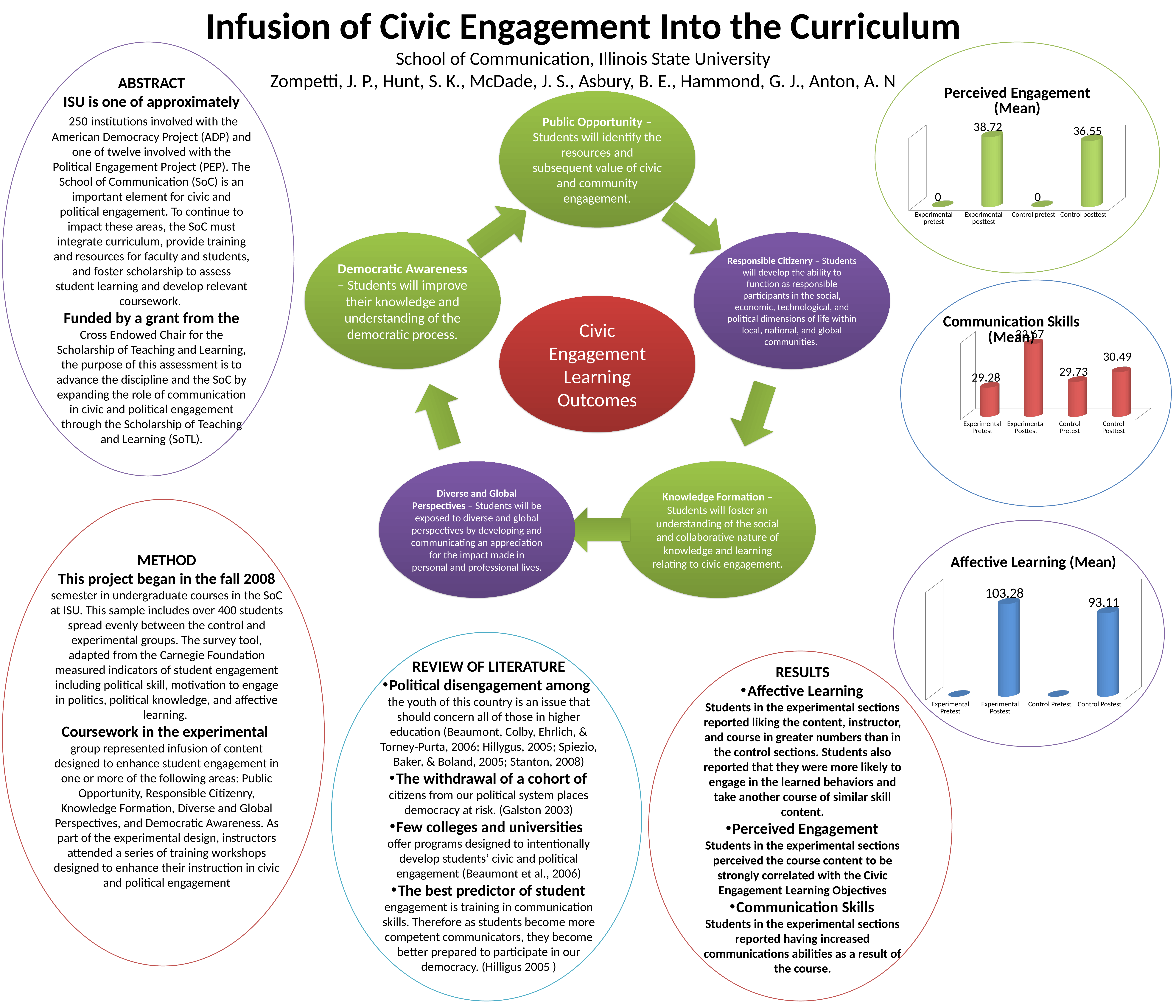
In the Perceived Engagement (Mean) chart, what is the difference between Experimental posttest and Control posttest? 2.17 In the Communication Skills (Mean) chart, what is the value for Control Posttest? 30.49 In the Perceived Engagement (Mean) chart, what is the value for Control posttest? 36.55 In the Perceived Engagement (Mean) chart, what is the value for Experimental posttest? 38.72 In the Perceived Engagement (Mean) chart, what is the value for Experimental pretest? 0 In the Communication Skills (Mean) chart, what is the difference between Control Posttest and Control Pretest? 0.76 In the Perceived Engagement (Mean) chart, which category has the highest value? Experimental posttest In the Affective Learning (Mean) chart, which is larger, Experimental Postest or Control Postest? Experimental Postest In the Communication Skills (Mean) chart, what is the value for Experimental Pretest? 29.28 In the Affective Learning (Mean) chart, what is the value for Experimental Postest? 103.28 In the Communication Skills (Mean) chart, which category has the lowest value? Experimental Pretest How many categories does the Affective Learning (Mean) chart show? 4